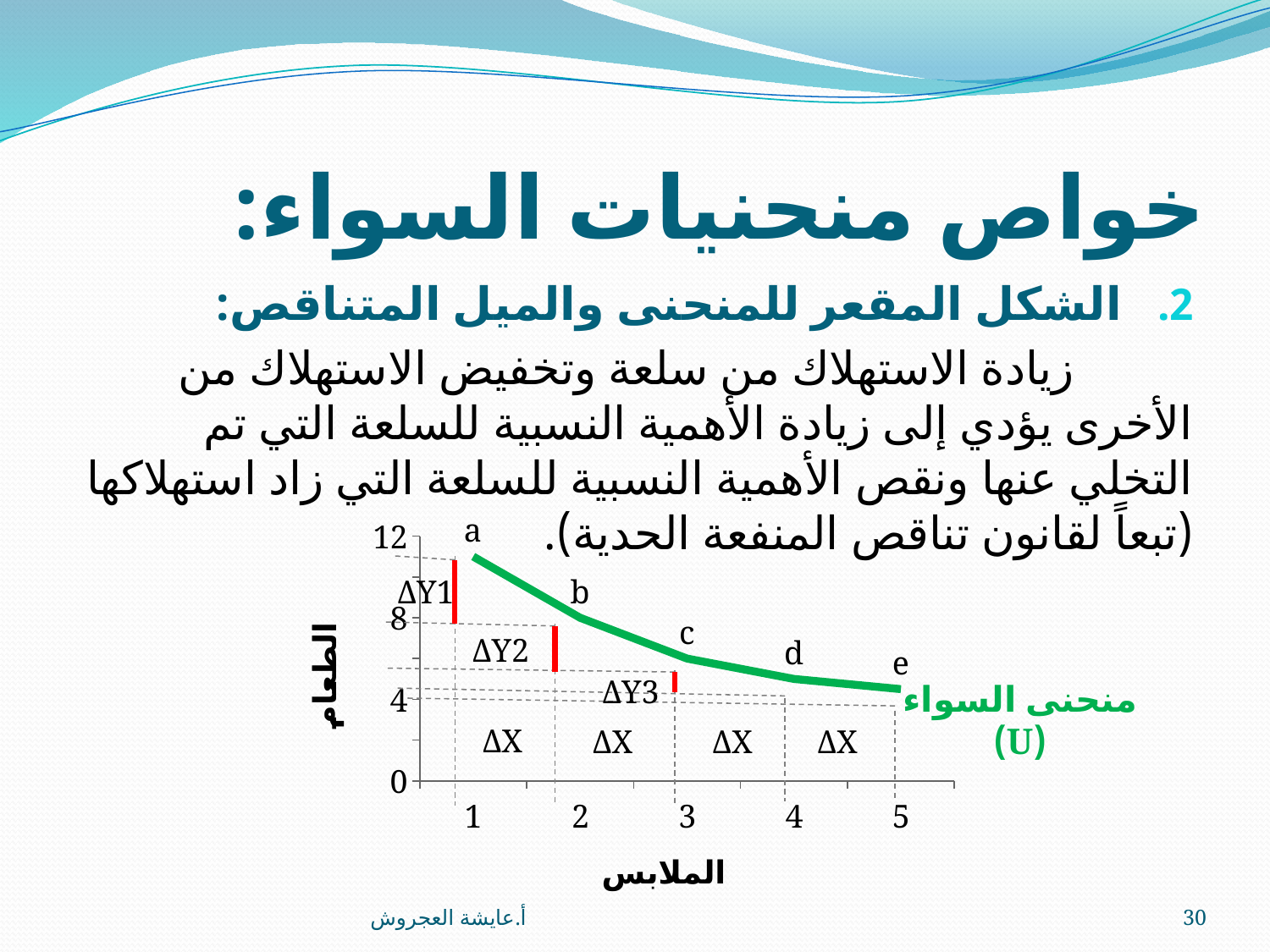
Which labelled point on the curve has the highest value on the vertical axis? a Is the value at point a greater or less than 8? greater Is the value at point b greater or less than 4? greater What kind of chart is shown on the slide? line chart Is the value at point e greater or less than 8? less What is the label given to the green curve on the chart? منحنى السواء (U) How many labelled points (a to e) are marked on the curve? 5 What is the label on the horizontal axis of the chart? الملابس Which point has a larger vertical-axis value, a or c? a Do the values on the curve rise or fall as the x axis increases from 1 to 5? fall